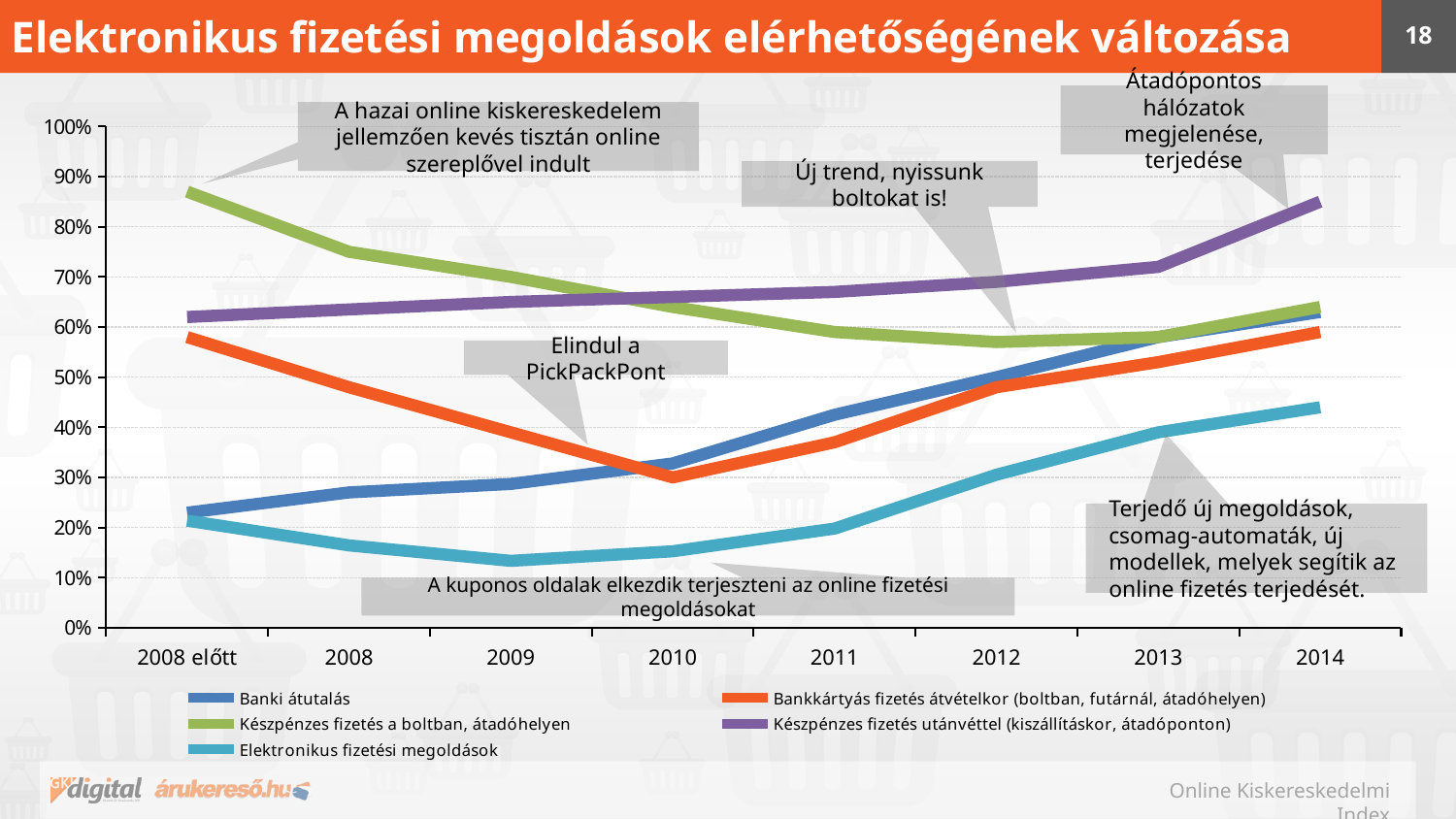
What is the title of the chart on the slide? Elektronikus fizetési megoldások elérhetőségének változása Is the value for Bankkártyás fizetés átvételkor in 2010 greater or less than 40%? less How many categories are shown on the x axis? 8 What kind of chart is shown on the slide? line chart Which series has the highest value in 2014? Készpénzes fizetés utánvéttel (kiszállításkor, átadóponton) Which series has the lowest value in 2009? Elektronikus fizetési megoldások Is the value for Készpénzes fizetés a boltban, átadóhelyen for 2008 előtt greater or less than 80%? greater In 2012, which is larger: Készpénzes fizetés a boltban, átadóhelyen or Elektronikus fizetési megoldások? Készpénzes fizetés a boltban, átadóhelyen Is the value for Elektronikus fizetési megoldások in 2014 greater or less than 40%? greater Does the Banki átutalás series rise or fall from 2008 előtt to 2014? rise In which year does the Elektronikus fizetési megoldások series reach its lowest point? 2009 How many series does the legend list? 5